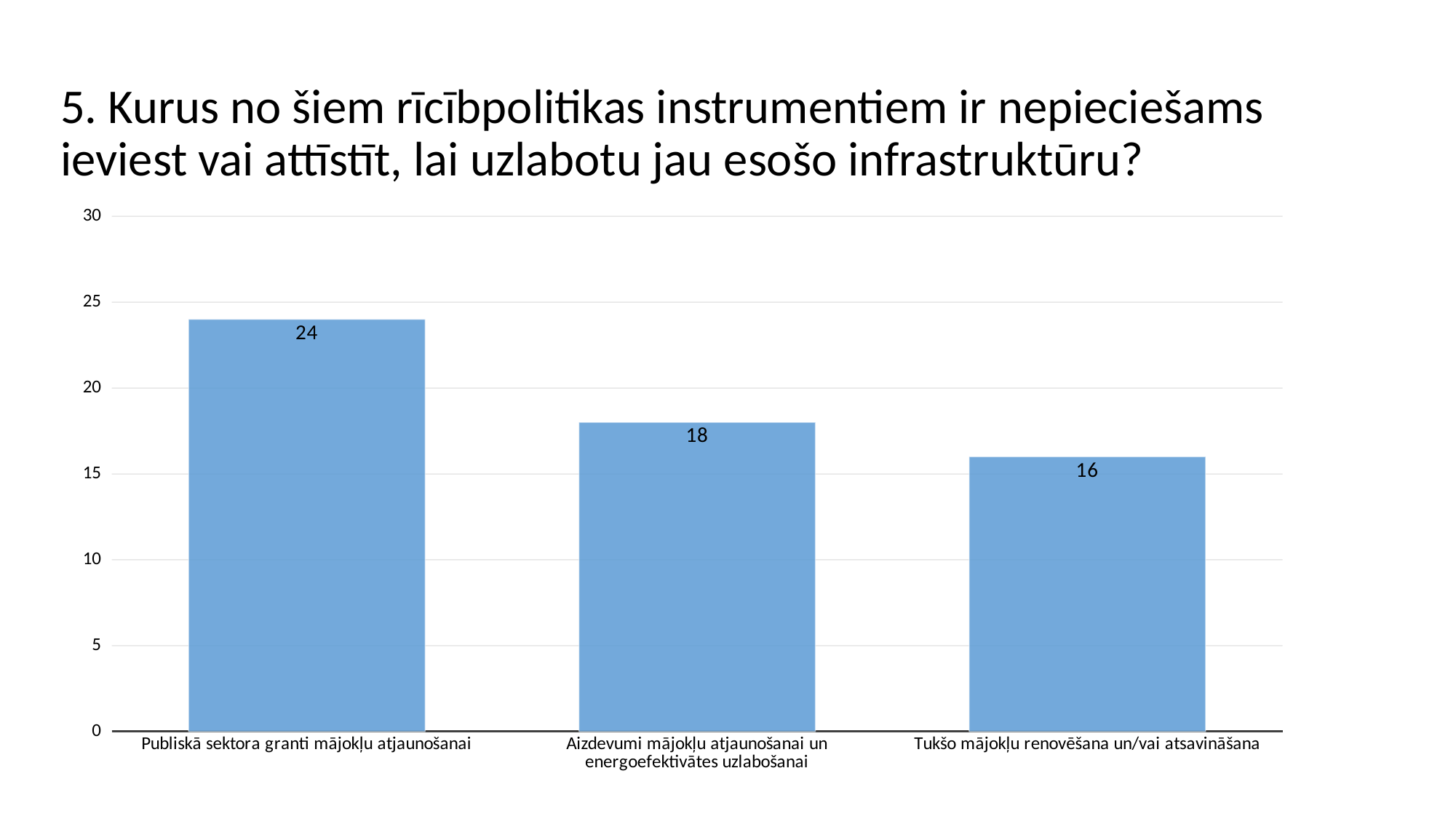
What is the value for 'Tukšo mājokļu renovēšana un/vai atsavināšana'? 16 What is the difference between the values for 'Publiskā sektora granti mājokļu atjaunošanai' and 'Tukšo mājokļu renovēšana un/vai atsavināšana'? 8 Which is larger: the value for 'Publiskā sektora granti mājokļu atjaunošanai' or for 'Aizdevumi mājokļu atjaunošanai un energoefektivātes uzlabošanai'? Publiskā sektora granti mājokļu atjaunošanai What kind of chart is shown on the slide? bar chart What is the value for 'Publiskā sektora granti mājokļu atjaunošanai'? 24 How many categories are shown in the chart? 3 What is the difference between the values for 'Aizdevumi mājokļu atjaunošanai un energoefektivātes uzlabošanai' and 'Tukšo mājokļu renovēšana un/vai atsavināšana'? 2 Do the values rise or fall from left to right across the categories? fall What is the value for 'Aizdevumi mājokļu atjaunošanai un energoefektivātes uzlabošanai'? 18 Which category has the lowest value? Tukšo mājokļu renovēšana un/vai atsavināšana Is the value for 'Tukšo mājokļu renovēšana un/vai atsavināšana' greater or less than 20? less Which category has the highest value? Publiskā sektora granti mājokļu atjaunošanai